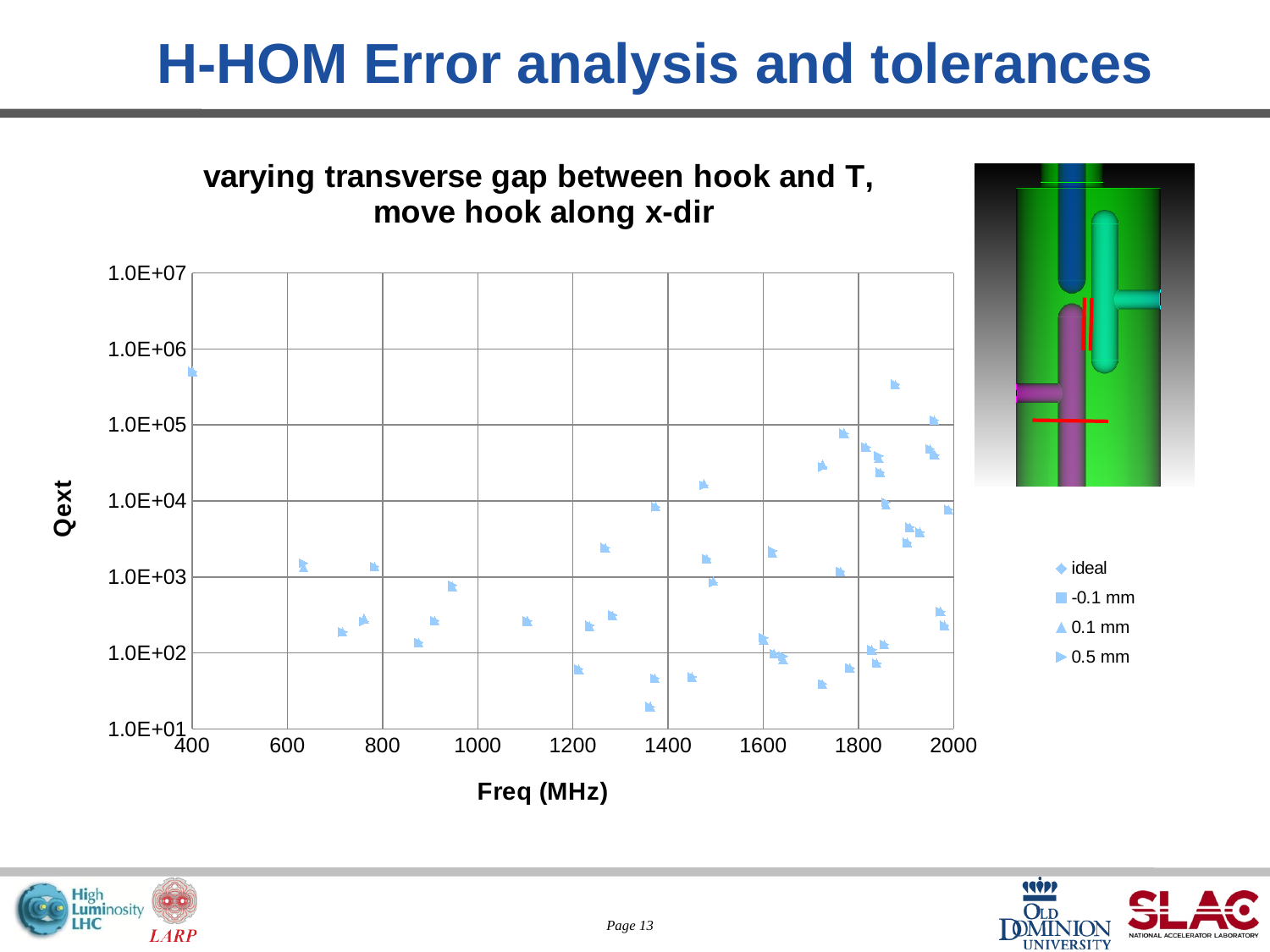
What is the label of the chart's x axis? Freq (MHz) How many series does the chart legend list? 4 What are the series names listed in the chart legend? ideal, -0.1 mm, 0.1 mm, 0.5 mm What kind of chart is shown on the slide? scatter chart Is the lowest plotted Qext value on the chart greater or less than 1.0E+02? less Is any point on the chart plotted above 1.0E+06? no Is the highest point plotted near 1880 MHz greater or less than 1.0E+05? greater